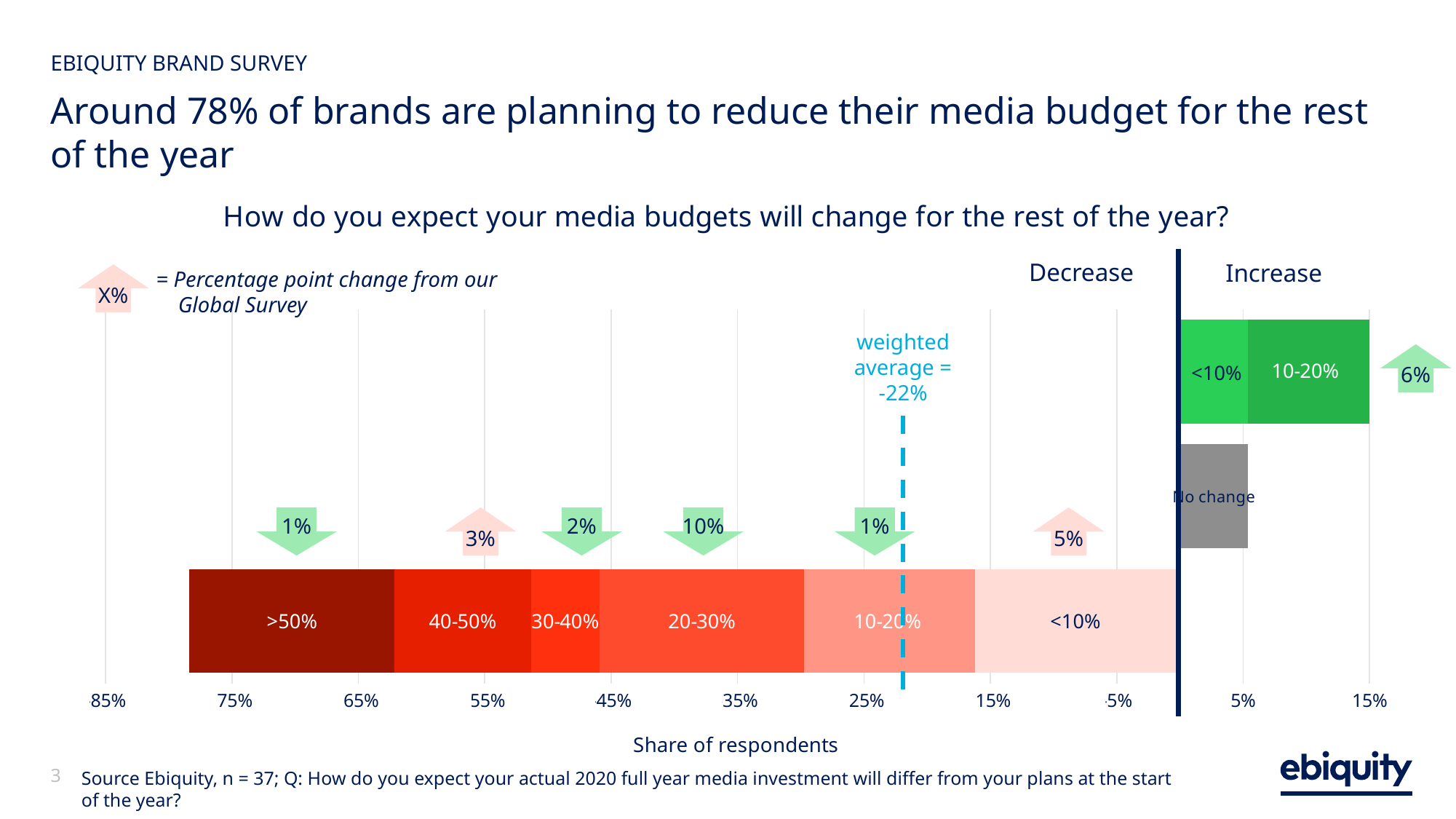
What is the percentage point change from the Global Survey shown above the <10% decrease segment? 5% Is the total share of respondents planning an increase greater or less than 10%? greater Is the total share of respondents planning a decrease greater or less than 75%? greater How many increase categories are shown in the green bar? 2 How many decrease categories are shown in the red stacked bar? 6 What is the label of the x axis? Share of respondents What is the percentage point change from the Global Survey shown above the 40-50% decrease segment? 3% What kind of chart is shown on the slide? Bar chart What is the percentage point change from the Global Survey shown above the 20-30% decrease segment? 10% What is the weighted average shown on the chart? -22% What is the title of the chart? How do you expect your media budgets will change for the rest of the year? What is the percentage point change from the Global Survey shown next to the increase bar? 6%